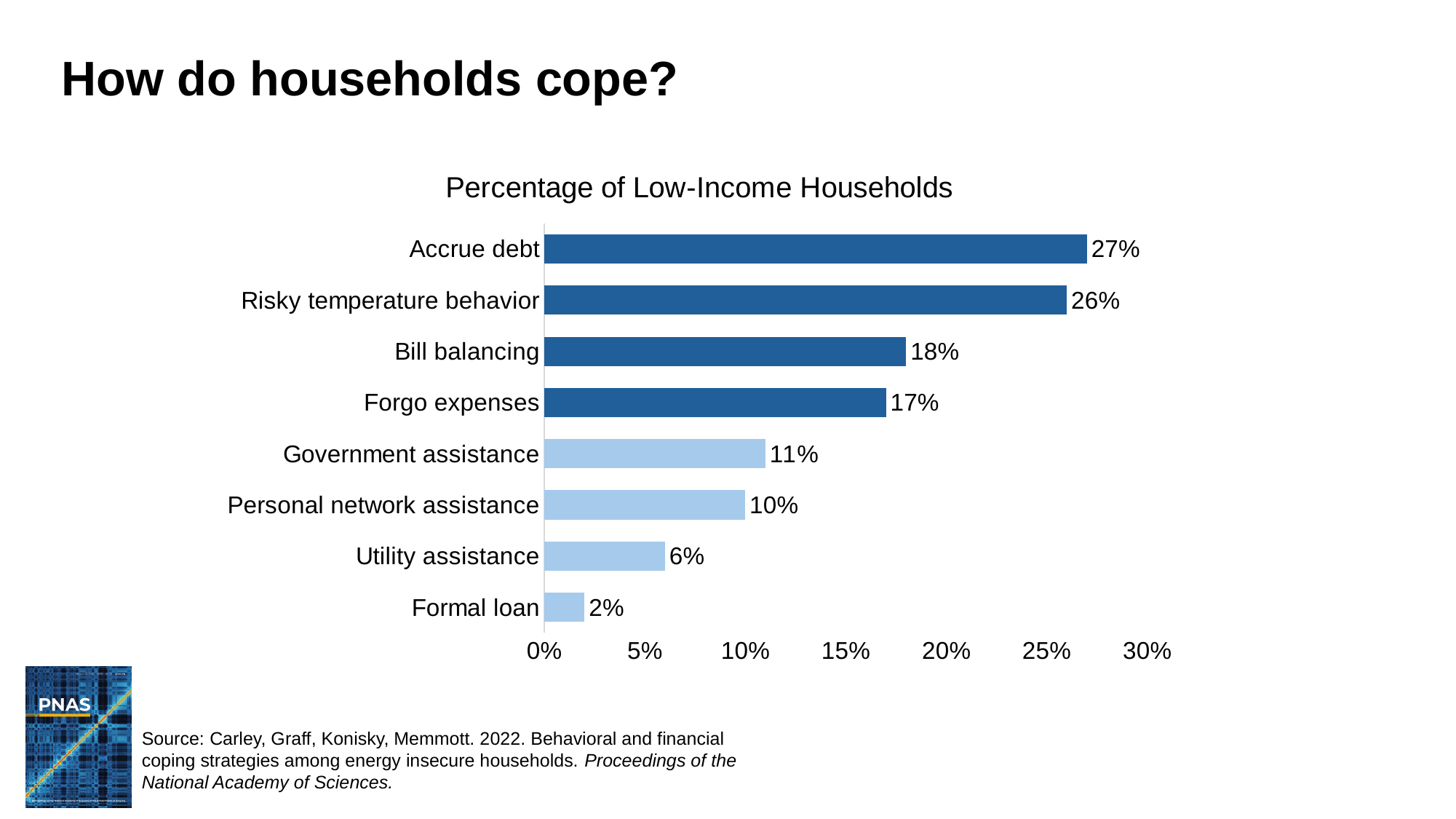
What is the difference between Bill balancing and Forgo expenses? 1% Which coping strategy has the lowest percentage? Formal loan What is the value for Government assistance? 11% What is the difference between Accrue debt and Formal loan? 25% What is the title of the chart? Percentage of Low-Income Households Which coping strategy has the highest percentage? Accrue debt What kind of chart is shown on the slide? Bar chart What percentage of low-income households accrue debt? 27% What is the value for Utility assistance? 6% How many coping strategies are shown in the chart? 8 Is the value for Risky temperature behavior greater or less than 25%? greater Which is larger, Personal network assistance or Utility assistance? Personal network assistance